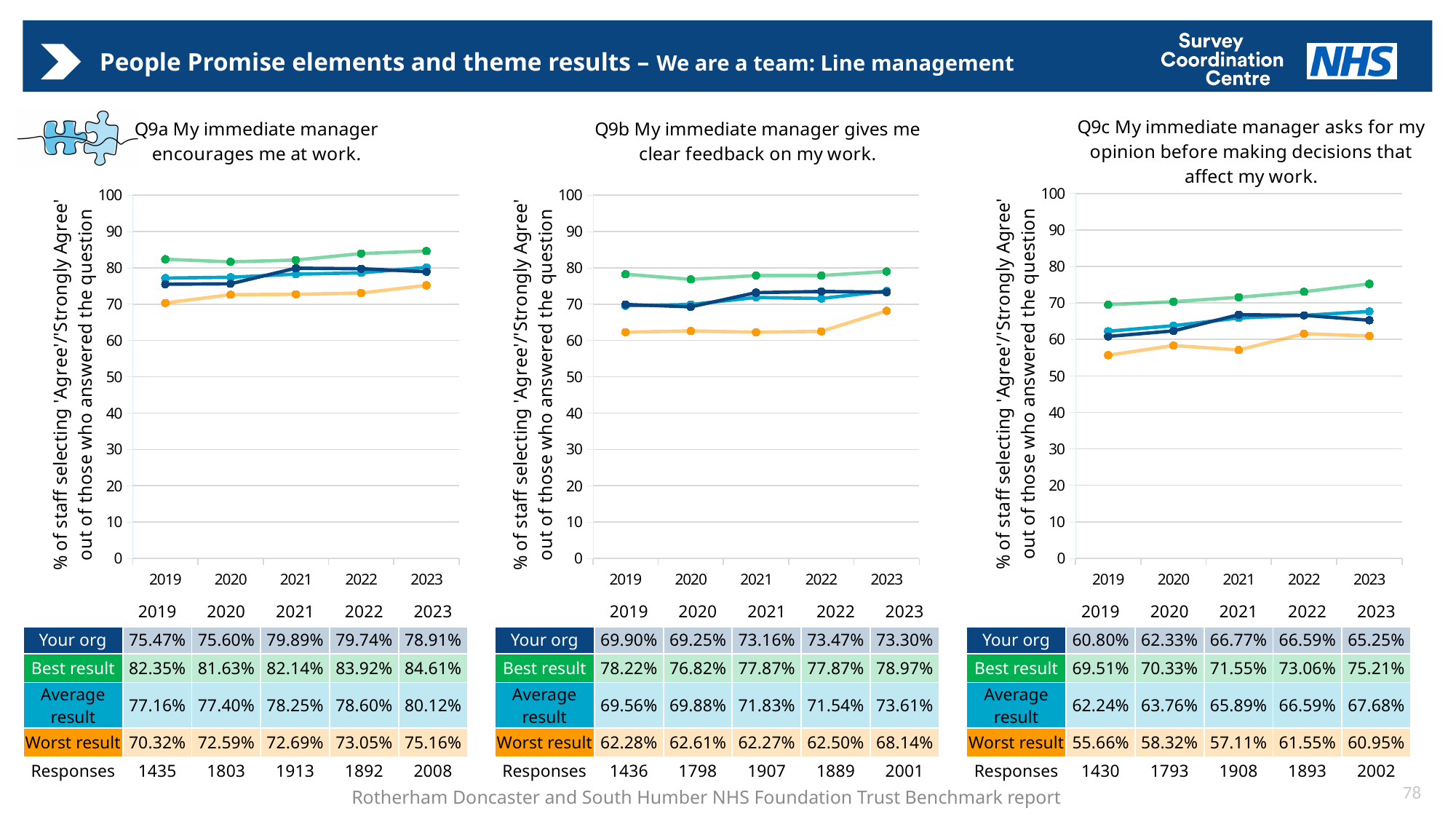
In the Q9b chart, what is the difference between the 'Best result' and 'Your org' values for 2023? 5.67% How many data series are plotted in the Q9a chart? 4 In the Q9c chart, which year has the lowest 'Worst result' value? 2019 In the Q9a chart, which year has the highest 'Best result' value? 2023 In the Q9a chart (My immediate manager encourages me at work), what is the 'Your org' value for 2023? 78.91% In the Q9c chart, does the 'Best result' series rise or fall from 2019 to 2023? Rise In the Q9c chart, which is larger for 2023: the 'Your org' value or the 'Average result' value? Average result In the Q9a chart, is the 'Worst result' value for 2019 greater or less than 80? less How many years are plotted on the x axis of the Q9b chart? 5 In the Q9c chart (My immediate manager asks for my opinion before making decisions that affect my work), what is the 'Best result' value for 2022? 73.06% What type of chart is used for Q9c? Line chart In the Q9b chart (My immediate manager gives me clear feedback on my work), what is the 'Worst result' value for 2023? 68.14%